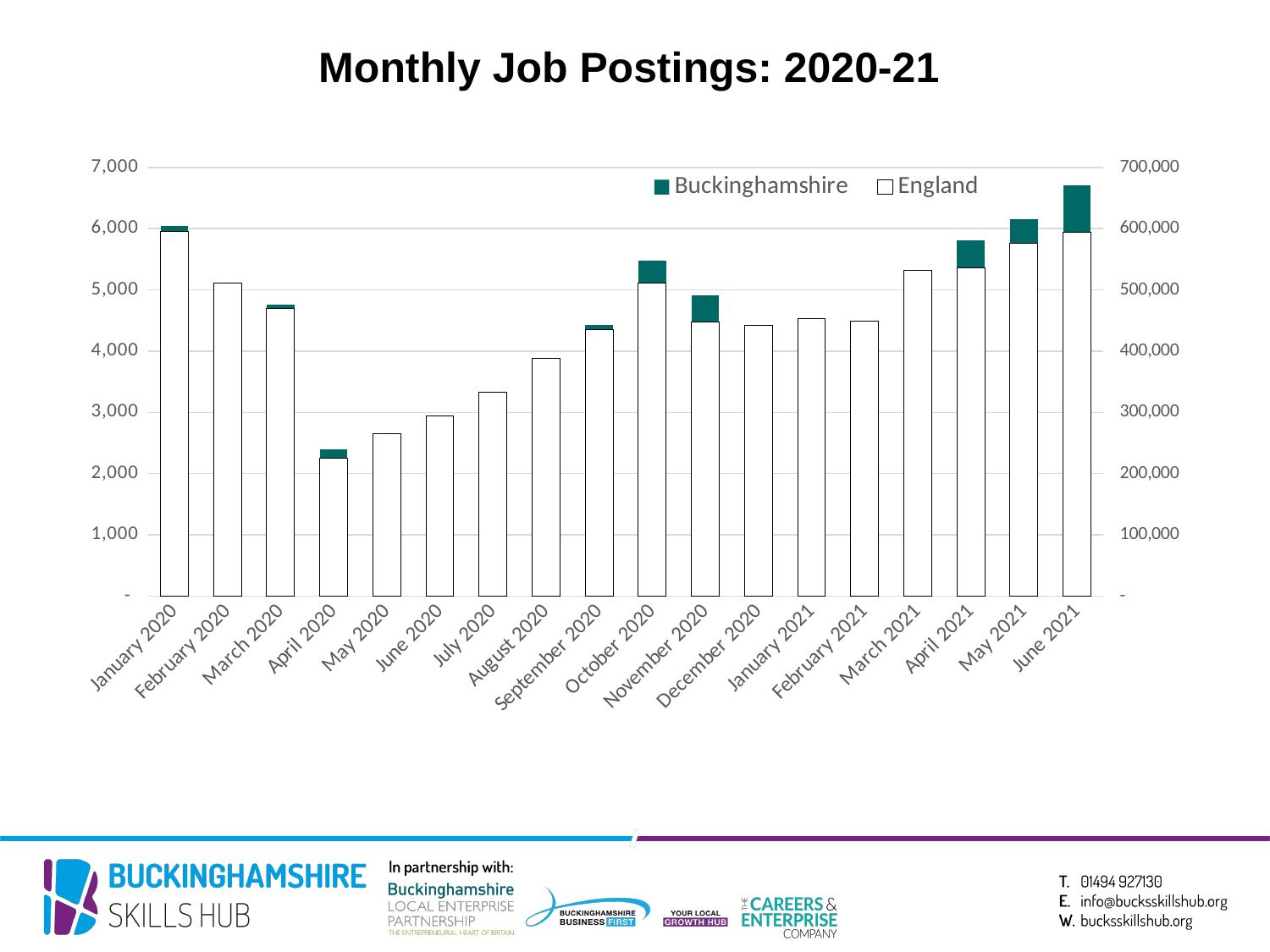
Which month has the larger England value, February 2020 or March 2020? February 2020 Is the Buckinghamshire value for April 2020 greater or less than 3,000? less Is the England value for March 2021 greater or less than 500,000? greater Which month has the highest Buckinghamshire job postings? June 2021 Do the England job postings rise or fall from April 2020 to October 2020? Rise Which month has the lowest England job postings? April 2020 What are the two entries in the chart's legend? Buckinghamshire and England Is the England value for April 2020 greater or less than 300,000? less What kind of chart is shown on the slide? Bar chart How many months are shown along the x axis? 18 How many series does the legend list? 2